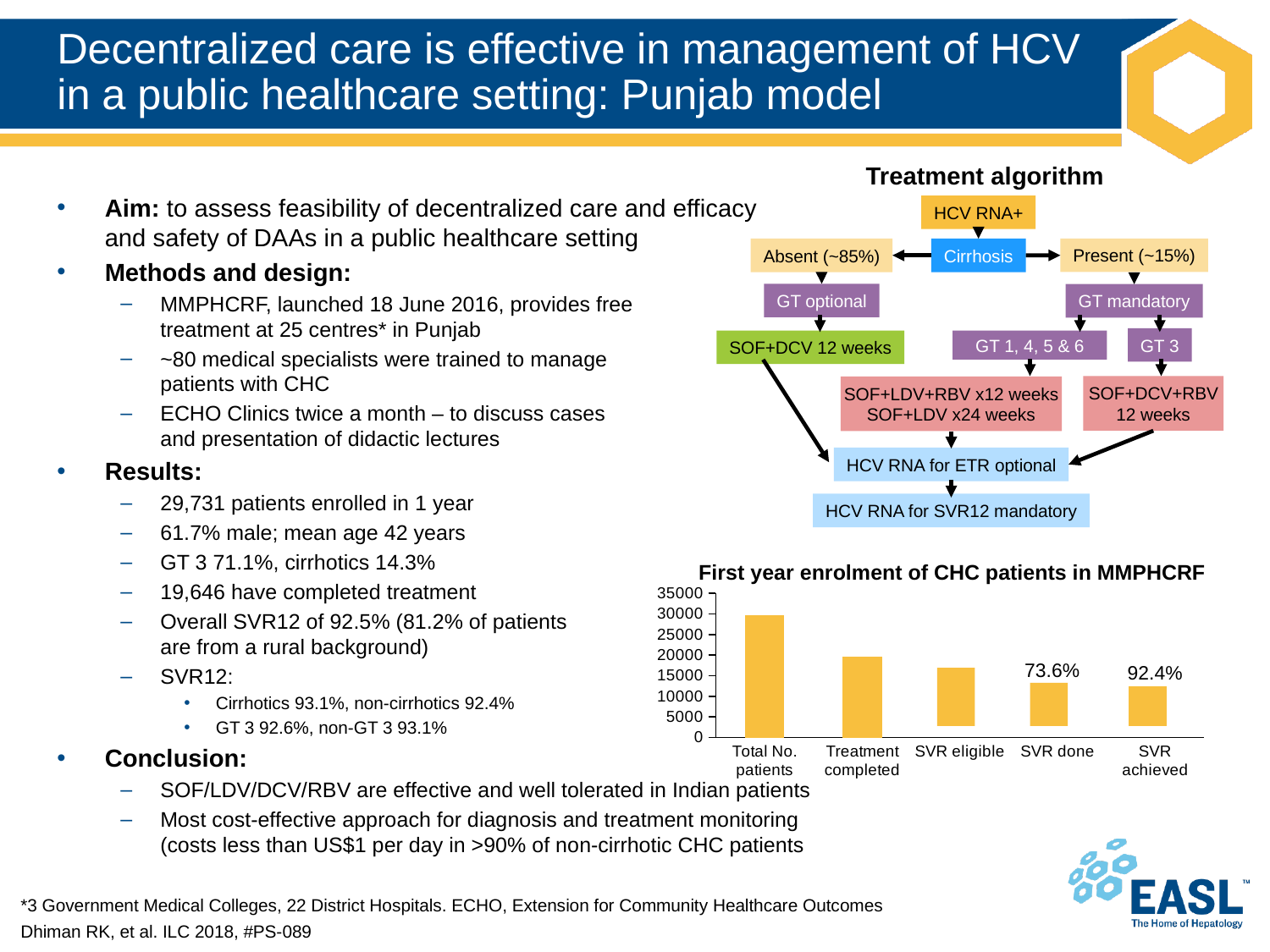
In the "First year enrolment of CHC patients in MMPHCRF" chart, is the value for "Treatment completed" greater or less than 15000? greater In the "First year enrolment of CHC patients in MMPHCRF" chart, is the value for "SVR done" greater or less than 15000? less In the "First year enrolment of CHC patients in MMPHCRF" chart, what label is printed above the "SVR done" bar? 73.6% In the "First year enrolment of CHC patients in MMPHCRF" chart, what label is printed above the "SVR achieved" bar? 92.4% How many categories are shown on the x axis of the "First year enrolment of CHC patients in MMPHCRF" chart? 5 What is the title of the bar chart on the slide? First year enrolment of CHC patients in MMPHCRF In the "First year enrolment of CHC patients in MMPHCRF" chart, is the value for "Total No. patients" greater or less than 25000? greater In the "First year enrolment of CHC patients in MMPHCRF" chart, do the bar values generally rise or fall from left to right? Fall In the "First year enrolment of CHC patients in MMPHCRF" chart, which category has the highest bar? Total No. patients What kind of chart is shown under the title "First year enrolment of CHC patients in MMPHCRF"? Bar chart In the "First year enrolment of CHC patients in MMPHCRF" chart, which is larger: "Treatment completed" or "SVR eligible"? Treatment completed